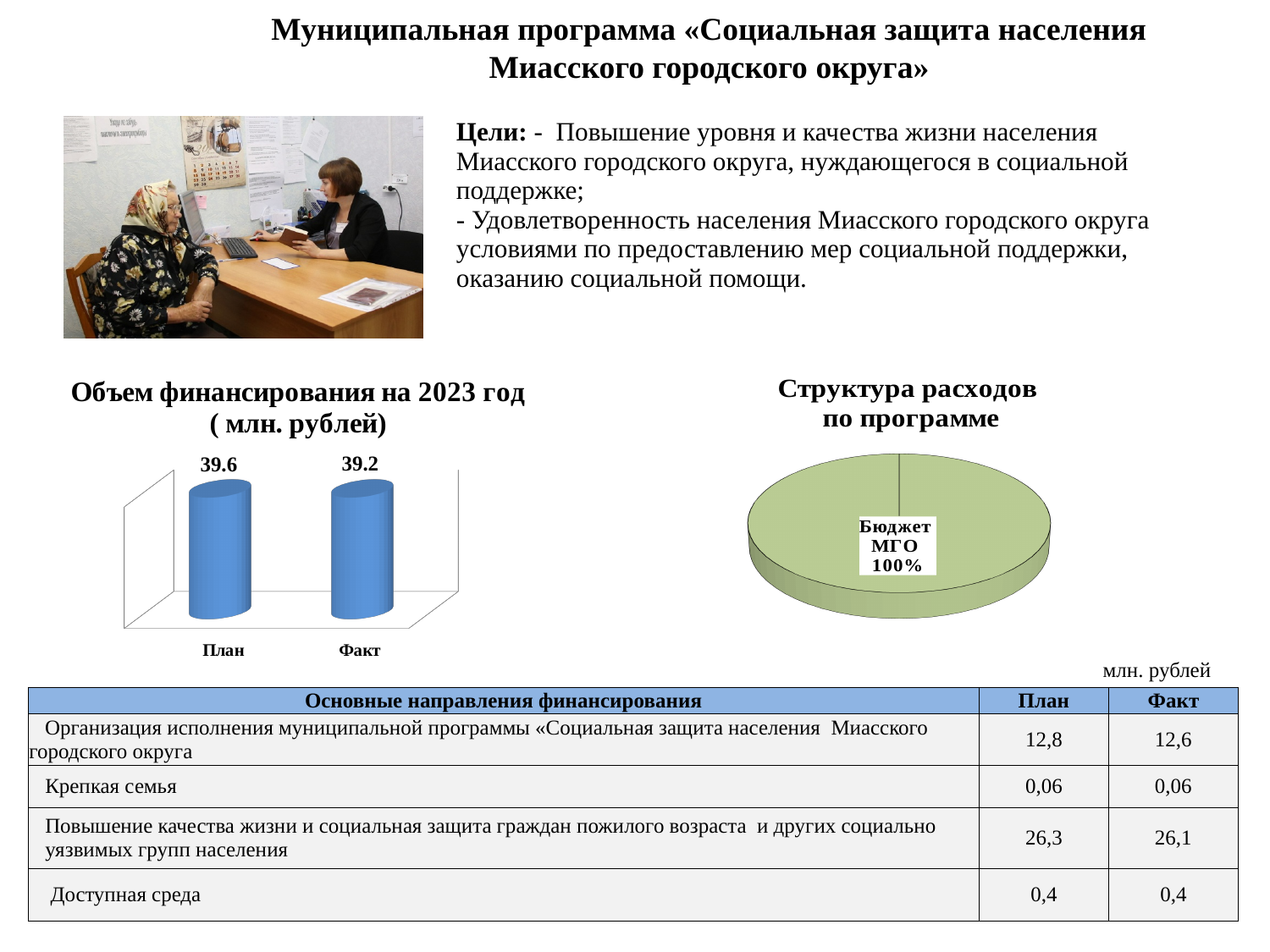
In the chart 'Объем финансирования на 2023 год', what is the difference between План and Факт? 0.4 In the chart 'Объем финансирования на 2023 год', is the value for План larger or smaller than the value for Факт? larger In the chart 'Структура расходов по программе', what share does Бюджет МГО have? 100% In the chart 'Объем финансирования на 2023 год', which category has the lower value? Факт In the chart 'Объем финансирования на 2023 год', which category has the higher value? План How many bars are shown in the chart 'Объем финансирования на 2023 год'? 2 What type of chart is 'Объем финансирования на 2023 год'? bar chart What unit is given in the title of the chart 'Объем финансирования на 2023 год'? млн. рублей How many slices does the pie chart 'Структура расходов по программе' have? 1 In the chart 'Объем финансирования на 2023 год', what is the value for Факт? 39.2 In the chart 'Объем финансирования на 2023 год', what is the value for План? 39.6 What type of chart is 'Структура расходов по программе'? pie chart